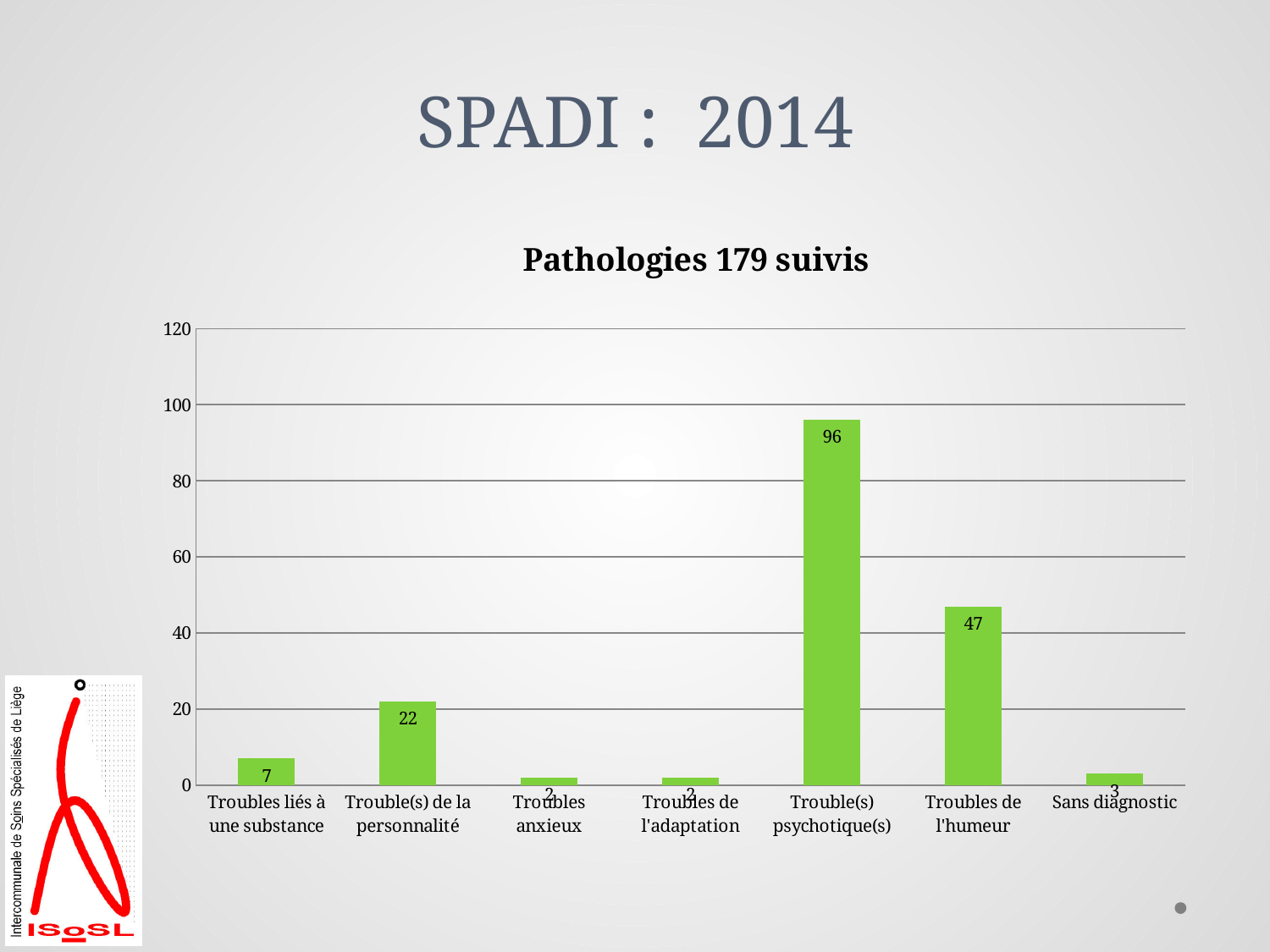
What is the title of the chart? Pathologies 179 suivis What kind of chart is shown? bar chart What is the value for Trouble(s) de la personnalité? 22 Which is larger, Trouble(s) de la personnalité or Troubles liés à une substance? Trouble(s) de la personnalité What is the value for Troubles de l'humeur? 47 How many categories are shown on the x axis? 7 Which category has the highest value? Trouble(s) psychotique(s) What is the value for Trouble(s) psychotique(s)? 96 Is the value for Troubles de l'humeur greater or less than 40? greater What is the value for Sans diagnostic? 3 What is the difference between Trouble(s) psychotique(s) and Troubles de l'humeur? 49 What is the value for Troubles liés à une substance? 7